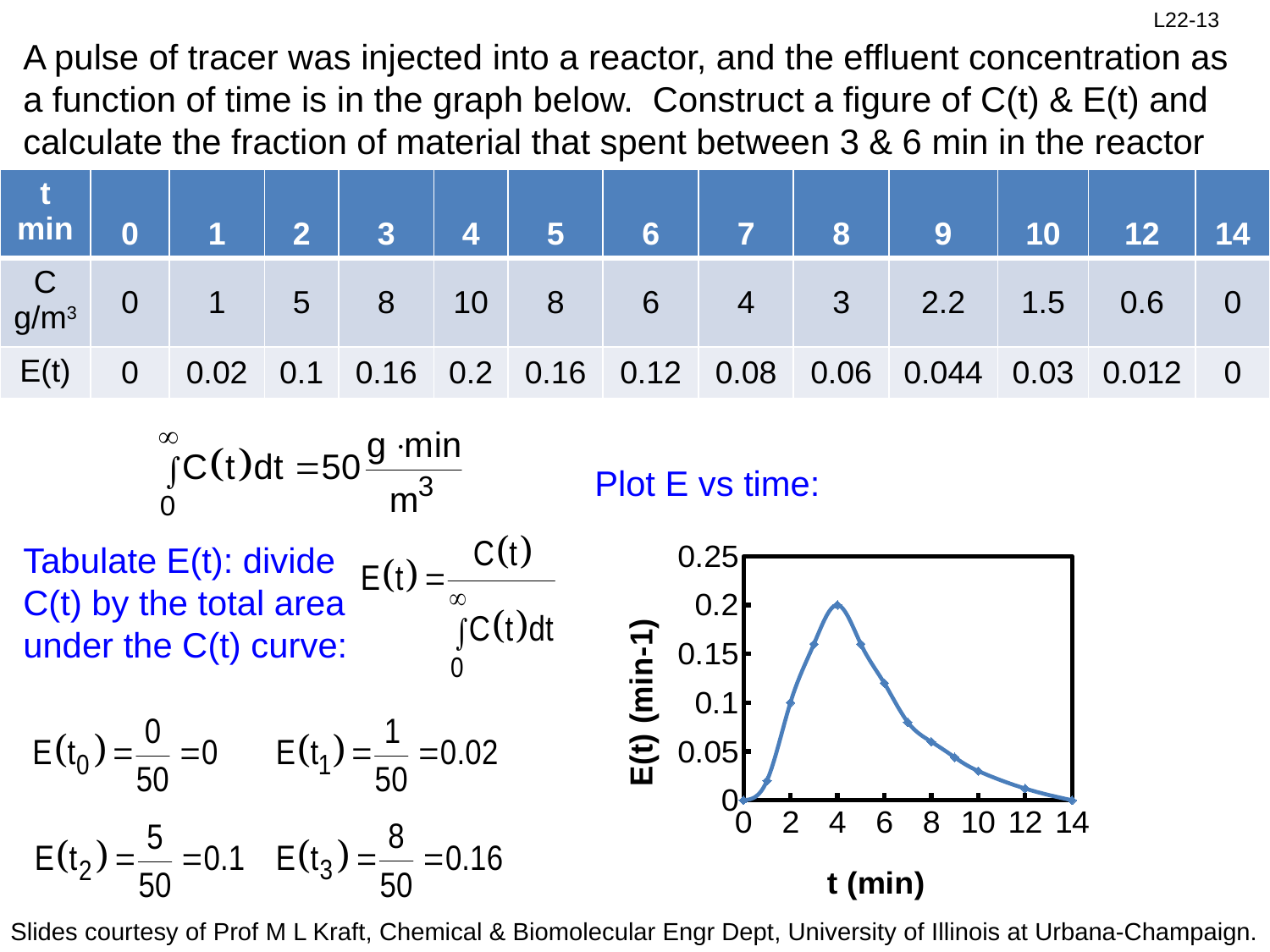
What is the value of E(t) at t = 2 min? 0.1 What kind of chart is shown on the slide? line chart What is the difference between E(t) at t = 4 min and E(t) at t = 8 min? 0.14 What is the value of E(t) at t = 3 min? 0.16 What is the value of E(t) at t = 14 min? 0 How many data points are plotted on the E vs time chart? 13 What is the label of the vertical axis of the chart? E(t) (min-1) At what time t (min) does E(t) reach its highest value on the chart? 4 Is the value of E(t) at t = 9 min greater or less than 0.05? less Which is larger, E(t) at t = 3 min or E(t) at t = 7 min? t = 3 min What is the peak value of E(t) on the chart? 0.2 Is the value of E(t) at t = 6 min greater or less than 0.1? greater